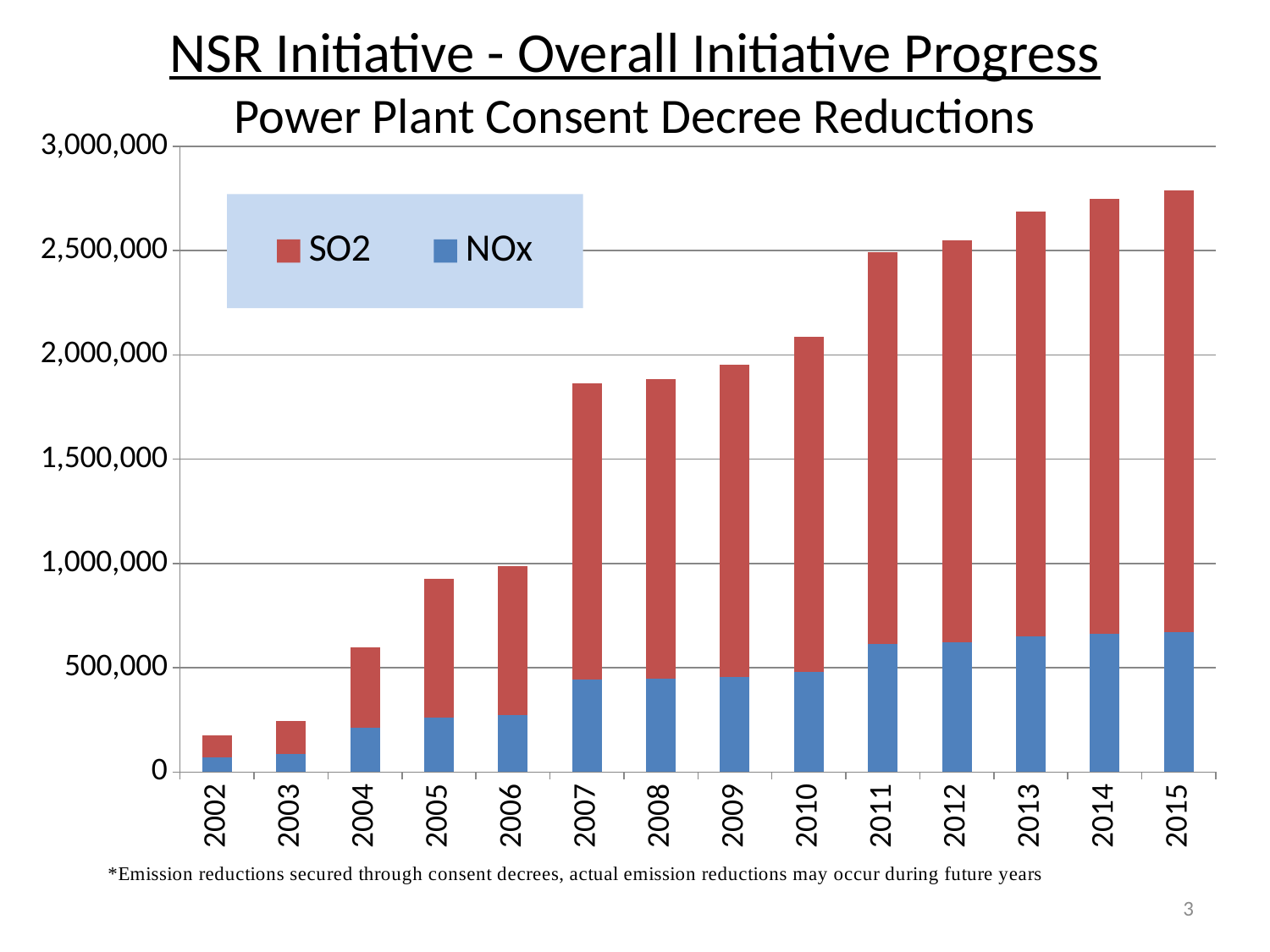
Which is larger, the total bar for 2007 or the total bar for 2006? 2007 How many years are shown on the x axis? 14 Is the total bar for 2015 greater or less than 2,500,000? greater Which year has the lowest total bar? 2002 Which year has the highest total bar? 2015 Do the total bar heights rise or fall from 2002 to 2015? rise How many series does the legend list? 2 What kind of chart is shown on the slide? stacked bar chart Which series is shown in red? SO2 What is the title of the chart? Power Plant Consent Decree Reductions Is the total bar for 2010 greater or less than 2,000,000? greater